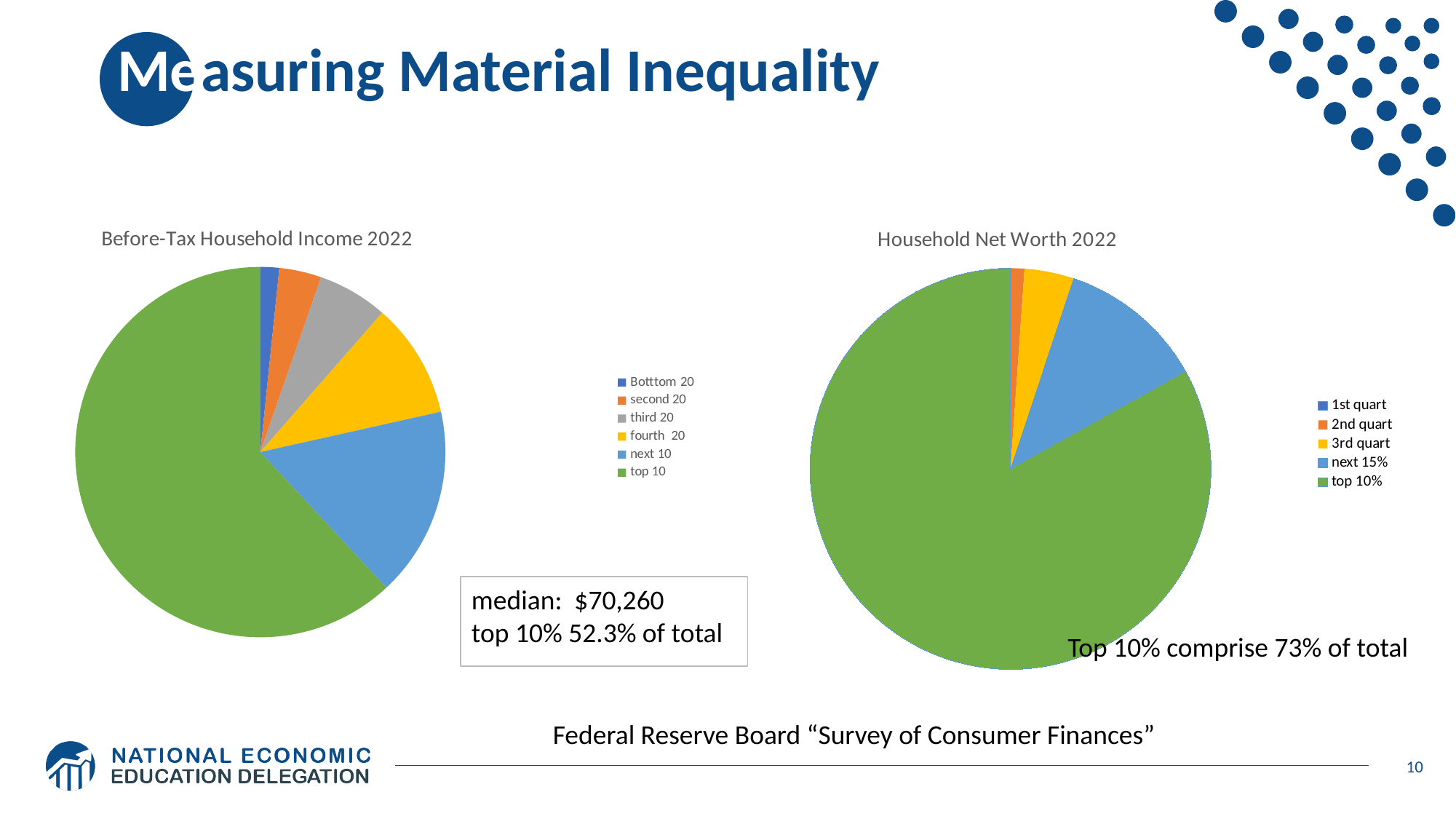
In the Household Net Worth 2022 chart, how many categories does the legend list? 5 What kind of chart is the Before-Tax Household Income 2022 chart? pie chart In the Household Net Worth 2022 chart, which category has the largest slice? top 10% In the Before-Tax Household Income 2022 chart, which category has the largest slice? top 10 In the Before-Tax Household Income 2022 chart, how many categories does the legend list? 6 In the Household Net Worth 2022 chart, which slice is larger: next 15% or 3rd quart? next 15% In the Before-Tax Household Income 2022 chart, which slice is larger: next 10 or fourth 20? next 10 What kind of chart is the Household Net Worth 2022 chart? pie chart In the Household Net Worth 2022 chart, what share of the total does the top 10% hold? 73% What is the median before-tax household income stated on the slide? $70,260 What colour represents the top 10 category in the Before-Tax Household Income 2022 chart? green In the Before-Tax Household Income 2022 chart, what share of the total does the top 10% hold? 52.3%